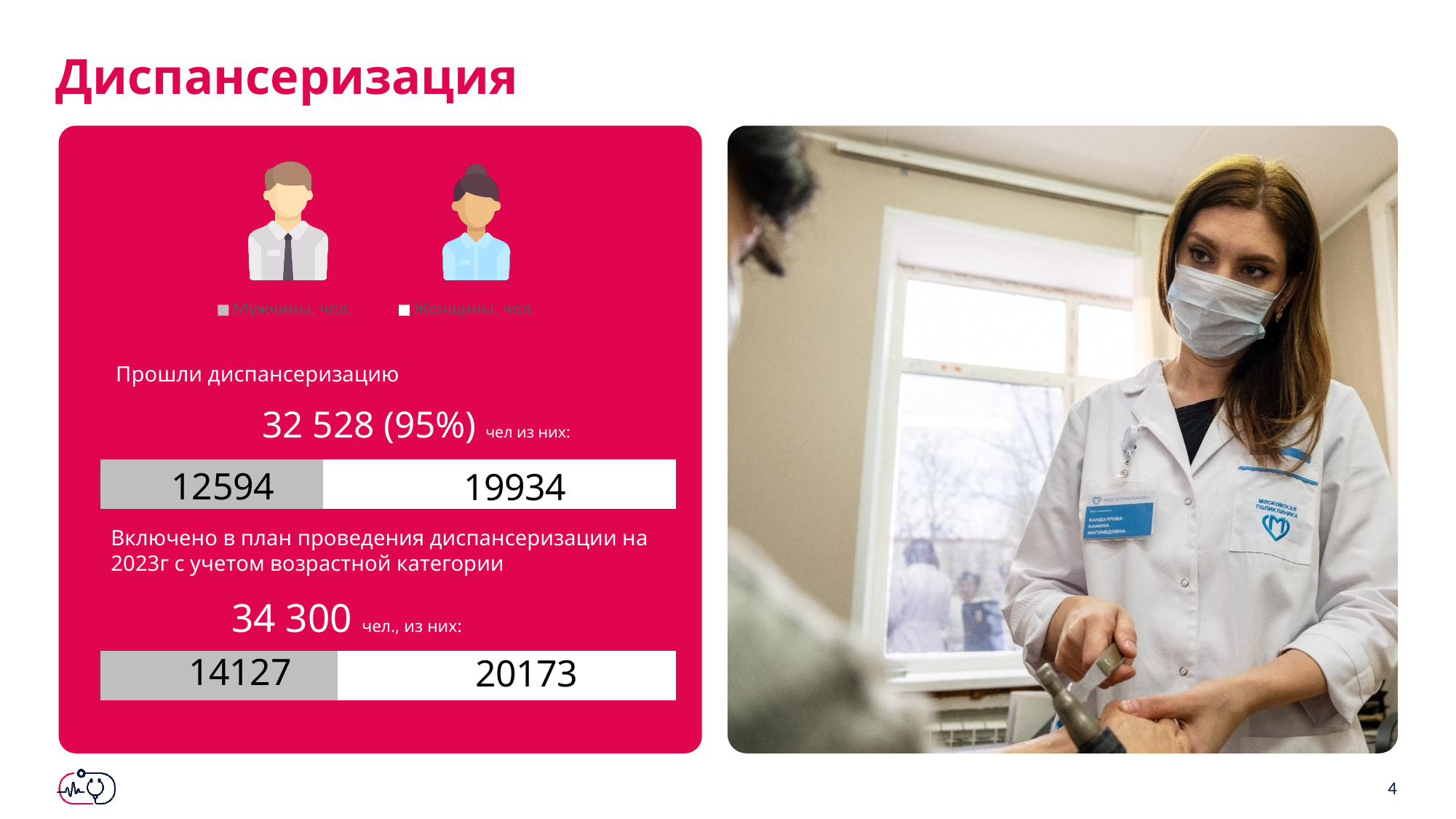
In the 'Прошли диспансеризацию' bar, what is the difference between Женщины and Мужчины? 7340 In the 'Прошли диспансеризацию' bar, what is the value for Мужчины, чел.? 12594 In the 'Прошли диспансеризацию' bar, which is larger: Мужчины or Женщины? Женщины In the 'Включено в план проведения диспансеризации на 2023г' bar, what is the difference between Женщины and Мужчины? 6046 In the 'Включено в план проведения диспансеризации на 2023г' bar, what is the value for Мужчины, чел.? 14127 In the 'Прошли диспансеризацию' bar, what is the value for Женщины, чел.? 19934 What kind of chart is used to show the Мужчины and Женщины values on the slide? Stacked bar chart What is the total of the 'Прошли диспансеризацию' stacked bar? 32 528 In the 'Включено в план проведения диспансеризации на 2023г' bar, which is larger: Мужчины or Женщины? Женщины In the 'Включено в план проведения диспансеризации на 2023г' bar, what is the value for Женщины, чел.? 20173 What is the total of the 'Включено в план проведения диспансеризации на 2023г' stacked bar? 34 300 How many series does the legend list for the bars on the slide? 2